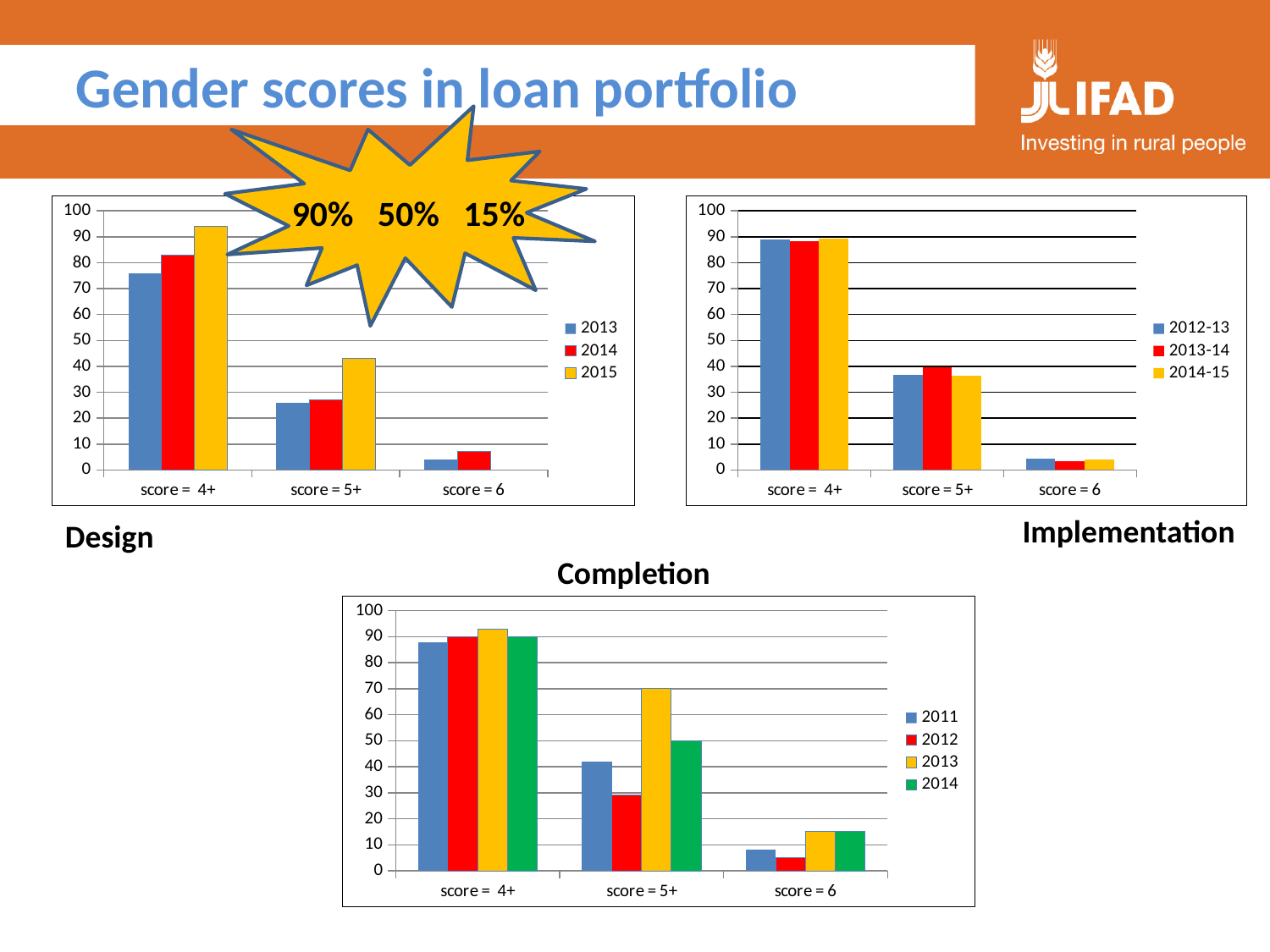
In the Completion chart (bottom), which is larger at score = 5+: 2011 or 2014? 2014 In the Completion chart (bottom), is the value for 2012 at score = 5+ greater or less than 40? less What type of chart is the Completion chart (bottom)? bar chart In the Completion chart (bottom), which year has the highest bar at score = 5+? 2013 In the Design chart (top left), is the value for 2015 at score = 4+ greater or less than 90? greater In the Design chart (top left), is the value for 2013 at score = 5+ greater or less than 30? less How many series does the legend of the Implementation chart (top right) list? 3 How many series does the legend of the Design chart (top left) list? 3 In the Implementation chart (top right), which category has the lowest bars overall? score = 6 How many series does the legend of the Completion chart (bottom) list? 4 In the Design chart (top left), which year has the highest bar at score = 5+? 2015